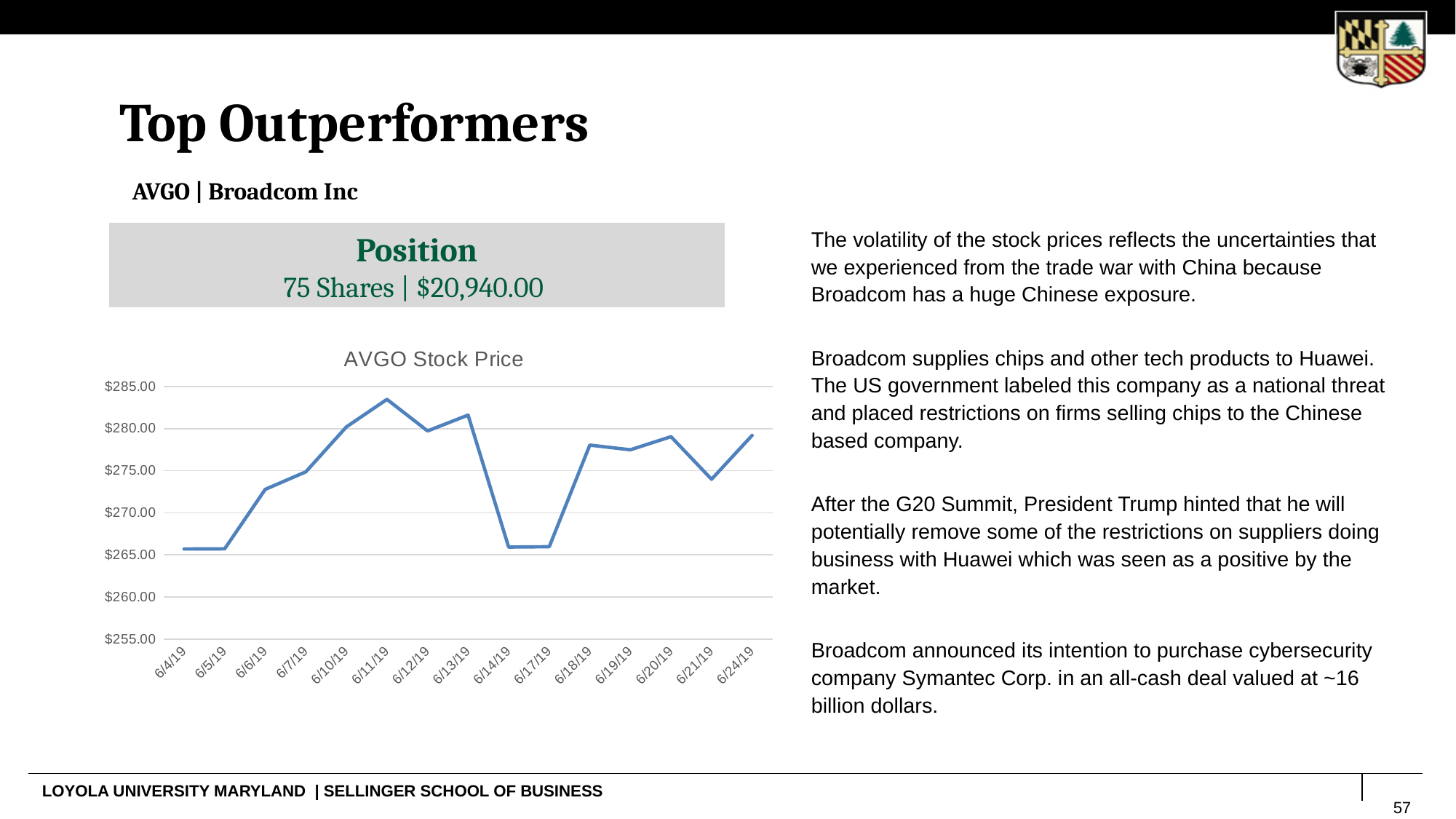
What kind of chart is shown on the slide? line chart Is the stock price on 6/11/19 greater or less than $280.00? greater Is the stock price on 6/14/19 greater or less than $270.00? less Is the stock price on 6/21/19 greater or less than $275.00? less What is the title of the chart? AVGO Stock Price On which date does the AVGO stock price reach its highest point? 6/11/19 Which date has the higher stock price, 6/13/19 or 6/17/19? 6/13/19 How many dates are plotted on the x axis of the chart? 15 Does the stock price rise or fall from 6/4/19 to 6/11/19? rise What is the highest value shown on the y axis of the chart? $285.00